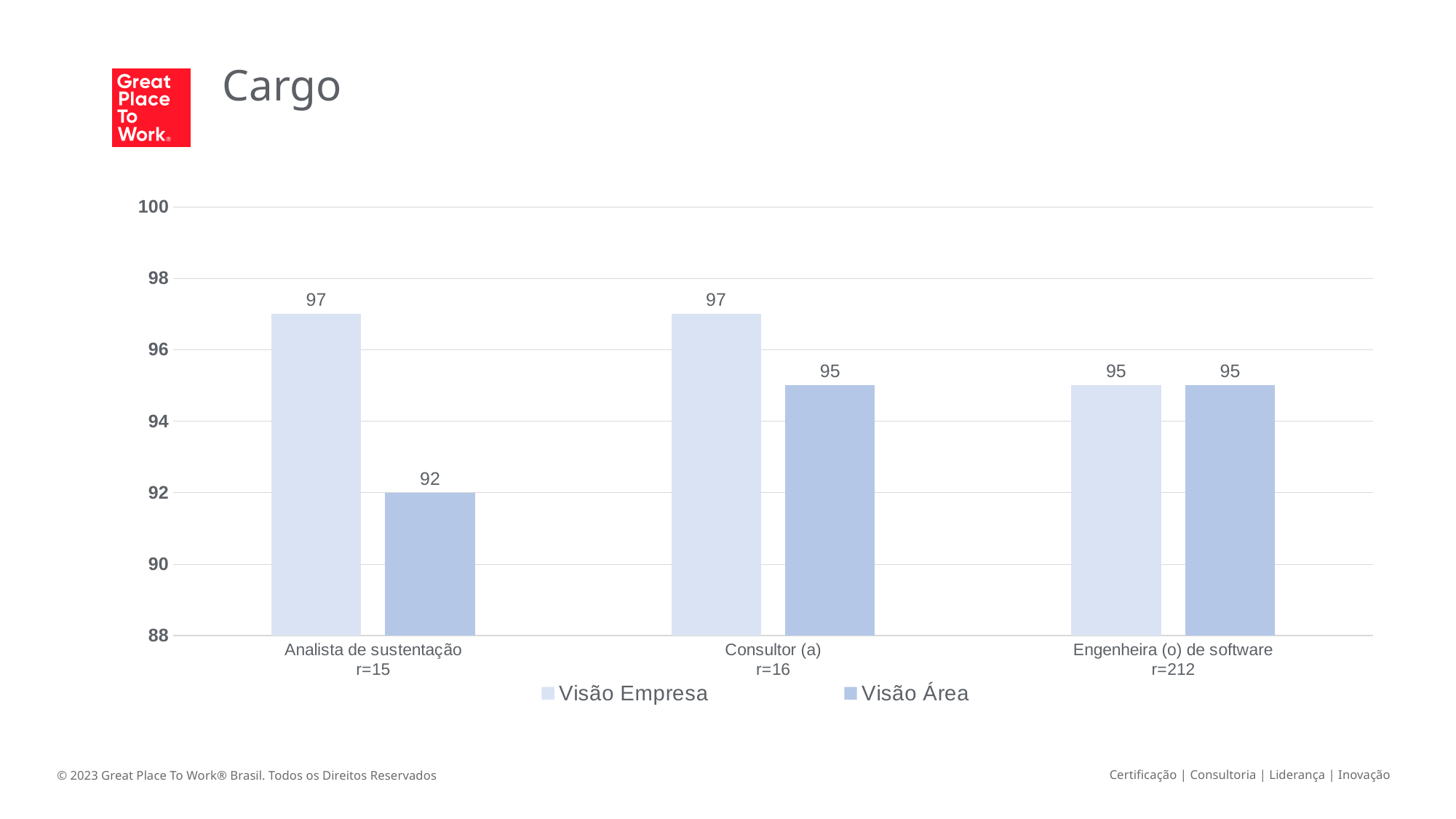
How many categories are shown on the x axis? 3 What is the Visão Empresa value for Consultor (a)? 97 What kind of chart is shown on the slide? Bar chart How many series does the legend list? 2 What is the Visão Área value for Engenheira (o) de software? 95 What is the Visão Área value for Analista de sustentação? 92 Which category has the lowest Visão Área value? Analista de sustentação Which is larger for Consultor (a): Visão Empresa or Visão Área? Visão Empresa What is the title of the chart? Cargo What is the difference between the Visão Empresa and Visão Área values for Analista de sustentação? 5 What is the difference between the Visão Empresa and Visão Área values for Consultor (a)? 2 Which category has the lowest Visão Empresa value? Engenheira (o) de software